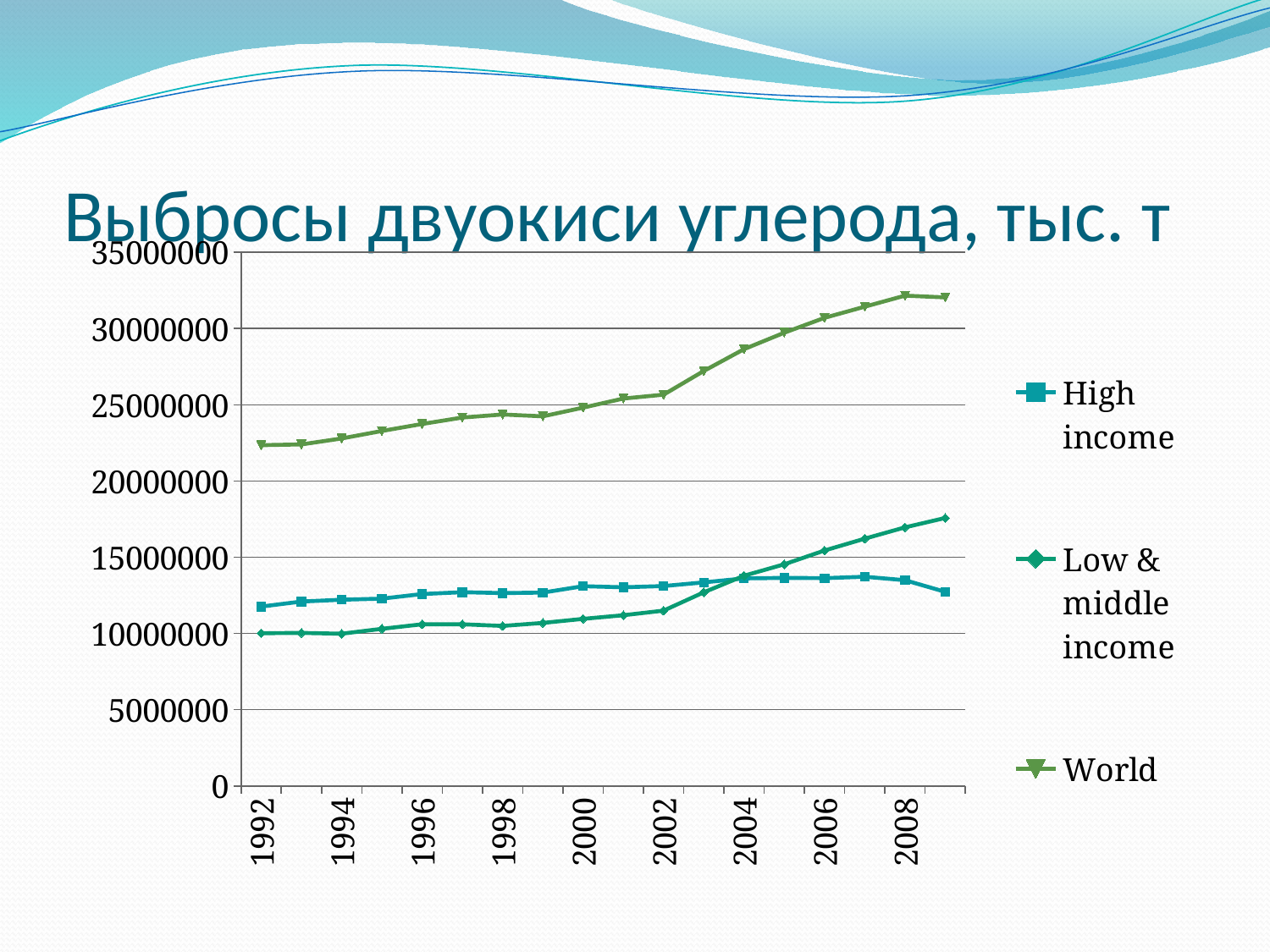
Which series has the highest values across all years? World Is the value for Low & middle income in 2008 greater or less than 15000000? greater Is the value for World in 1992 greater or less than 20000000? greater Is the value for High income in 2004 greater or less than 15000000? less What kind of chart is shown on the slide? line chart What is the title of the chart? Выбросы двуокиси углерода, тыс. т Do the values for the World series rise or fall from 1992 to 2008? rise In 1992, which series has the higher value: High income or Low & middle income? High income How many series does the legend list? 3 In 2008, which series has the higher value: High income or Low & middle income? Low & middle income